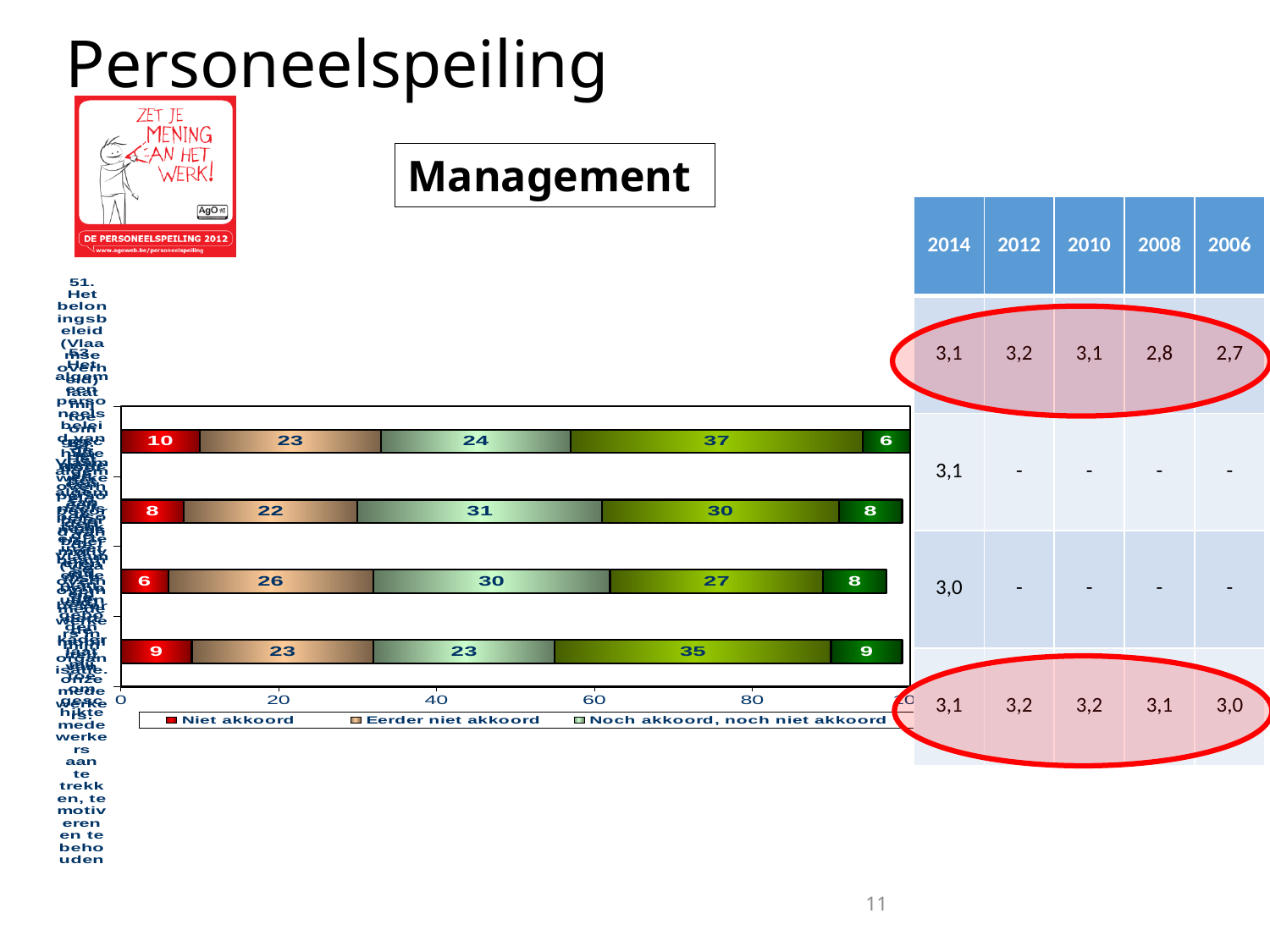
What is the total of all segments in the top bar? 100 What is the first entry in the chart's legend? Niet akkoord Which bar has the largest 'Niet akkoord' segment? The top bar What is the 'Niet akkoord' value for the top bar of the chart? 10 How many bars does the chart contain? 4 What kind of chart is shown on the slide? Stacked bar chart What is the difference between the 'Noch akkoord, noch niet akkoord' values of the second bar and the top bar? 7 Which bar has the smallest 'Niet akkoord' segment? The third bar from the top Is the 'Niet akkoord' value larger for the top bar or the bottom bar? The top bar What is the 'Eerder niet akkoord' value for the bottom bar of the chart? 23 What is the 'Noch akkoord, noch niet akkoord' value for the third bar from the top? 30 What is the total of all segments in the third bar from the top? 97